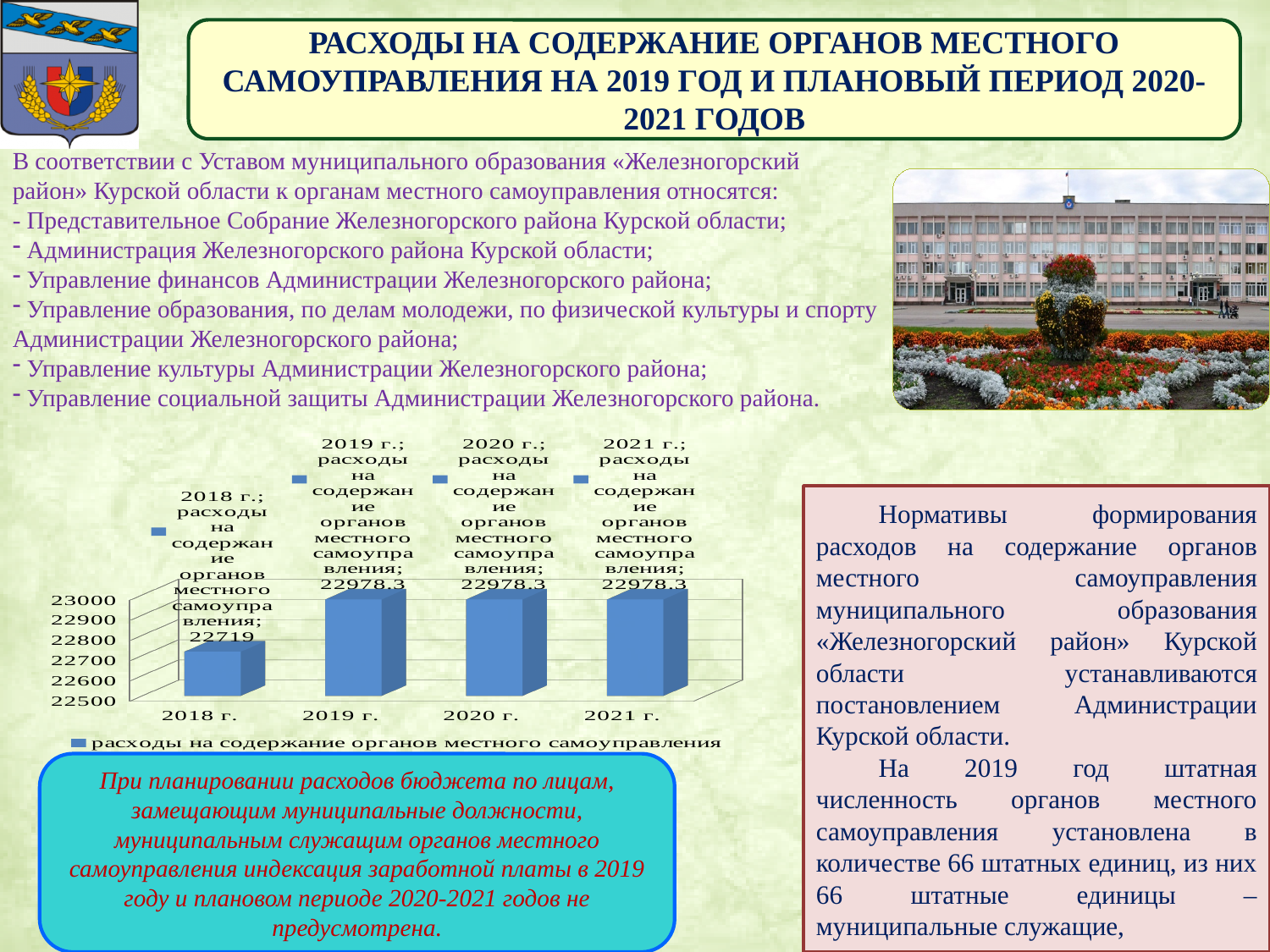
Which year has the lowest value in the chart? 2018 г. What kind of chart is shown on the slide? bar chart What is the value for 2019 г. in the chart? 22978.3 Does the value rise or fall from 2018 г. to 2019 г.? rise What is the difference between the values for 2019 г. and 2018 г.? 259.3 Is the value for 2018 г. greater or less than 22800? less How many series does the chart legend list? 1 What is the series name shown in the chart legend? расходы на содержание органов местного самоуправления How many years (categories) are shown on the x axis of the chart? 4 What is the value for 2021 г. in the chart? 22978.3 Which is larger, the value for 2018 г. or the value for 2021 г.? 2021 г. What is the value for 2018 г. in the chart? 22719